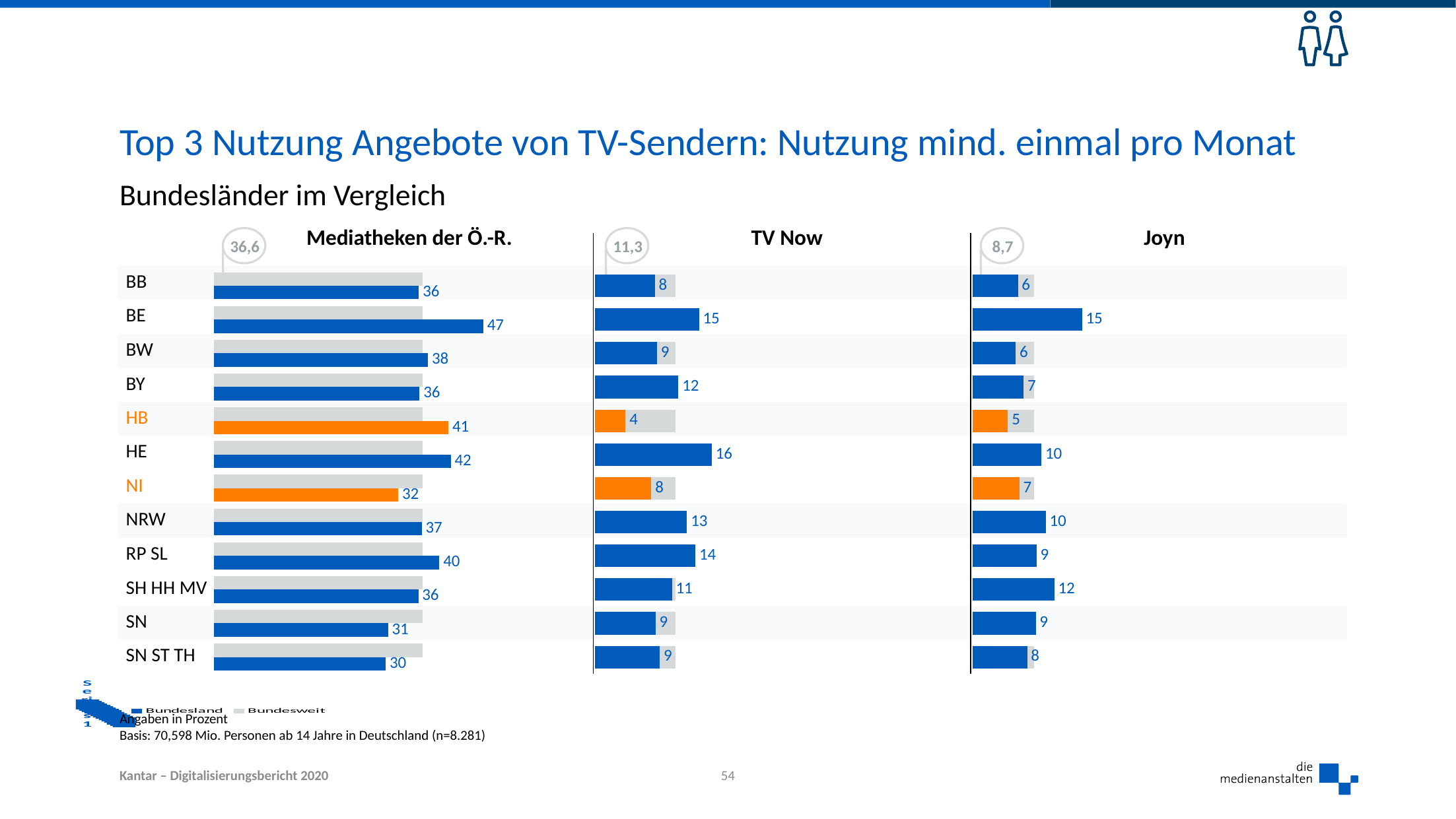
How many Bundesländer (categories) are shown in the Joyn chart? 12 In the Mediatheken der Ö.-R. chart, what is the value for BE? 47 In the Joyn chart, which Bundesland has the highest value? BE In the Joyn chart, what is the value for SH HH MV? 12 In the TV Now chart, which is larger, the value for BY or the value for NRW? NRW In the Mediatheken der Ö.-R. chart, what is the difference between the values for BE and NI? 15 In the TV Now chart, what is the value for HE? 16 What is the Bundesweit (nationwide) value shown for the Mediatheken der Ö.-R. chart? 36,6 In the TV Now chart, which Bundesland has the lowest value? HB In the Mediatheken der Ö.-R. chart, which Bundesland has the lowest value? SN ST TH How many series does the legend list? 2 What kind of chart is the TV Now chart? bar chart